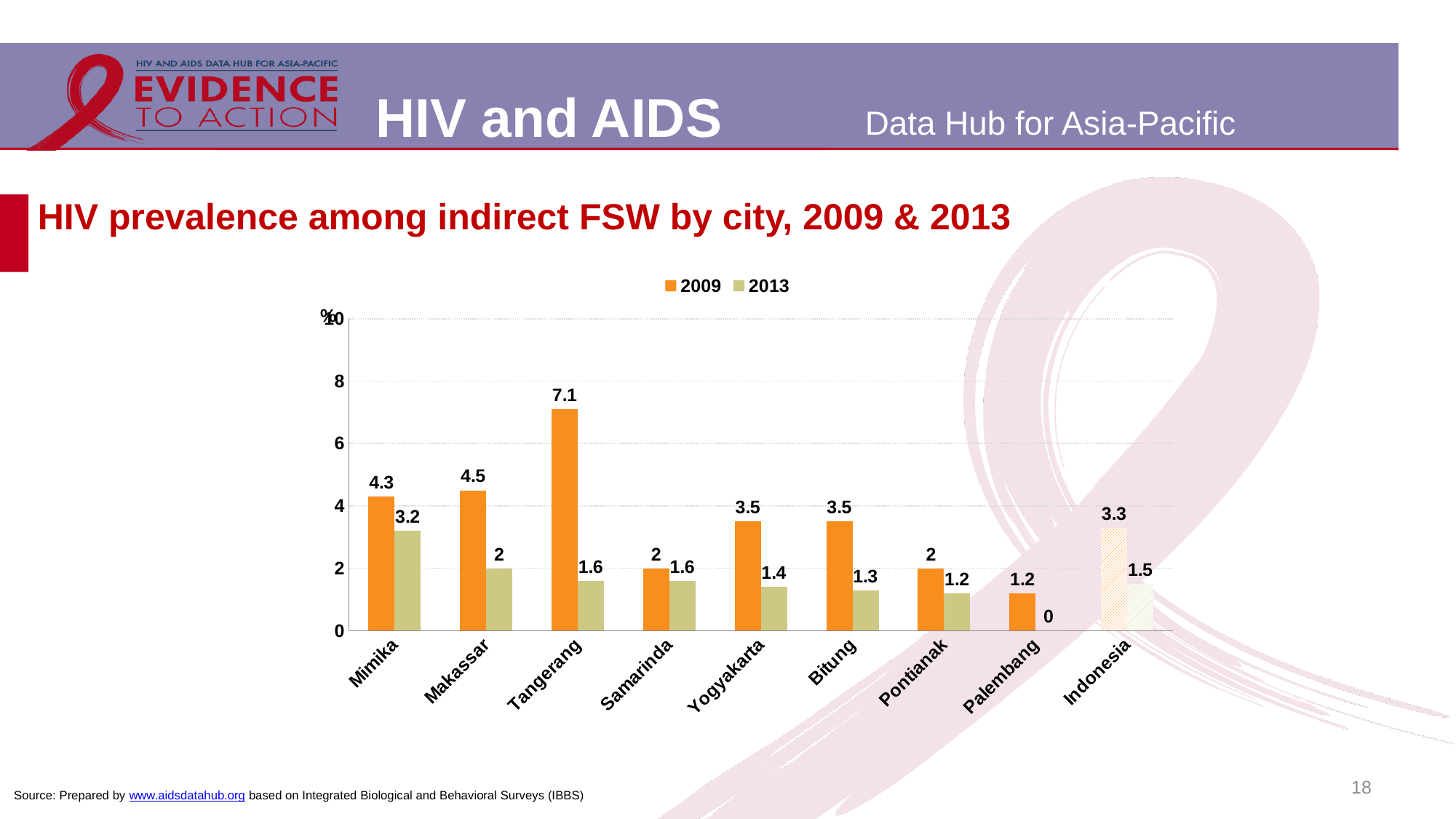
What is the 2013 value for Palembang? 0 What is the 2013 HIV prevalence value for Mimika? 3.2 Which is larger for Makassar: the 2009 value or the 2013 value? 2009 What are the two series listed in the legend? 2009 and 2013 What kind of chart is shown on the slide? Bar chart What is the 2009 HIV prevalence value for Tangerang? 7.1 Which city has the highest 2009 HIV prevalence? Tangerang How many cities/categories are shown on the x axis? 9 What is the difference between the 2009 and 2013 values for Tangerang? 5.5 What is the 2009 value for Indonesia? 3.3 Which category has the lowest 2013 value? Palembang How many series does the legend list? 2